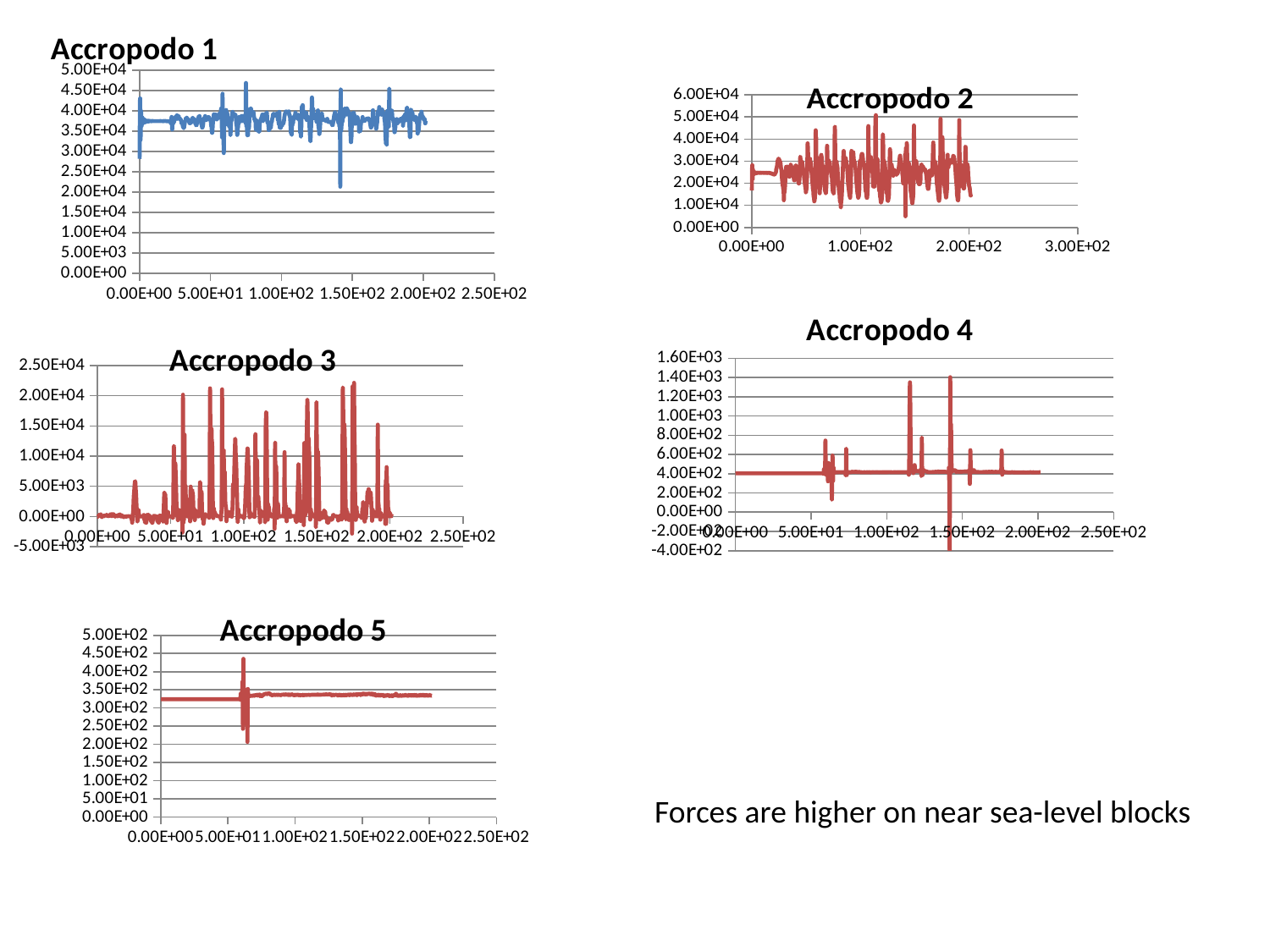
In the Accropodo 2 chart, is the highest peak greater or less than 4.00E+04? greater In the Accropodo 1 chart, is the lowest point greater or less than 2.50E+04? less In the Accropodo 5 chart, do the values generally rise, fall, or stay roughly flat along the x axis? roughly flat What kind of chart is Accropodo 1? line chart In the Accropodo 4 chart, is the highest peak greater or less than 1.20E+03? greater What colour is the line plotted in the Accropodo 1 chart? blue How many charts are shown on the slide? 5 How many lines are plotted in the Accropodo 3 chart? 1 Which chart has the larger highest peak, Accropodo 4 or Accropodo 5? Accropodo 4 What is the title of the chart in the top-left corner of the slide? Accropodo 1